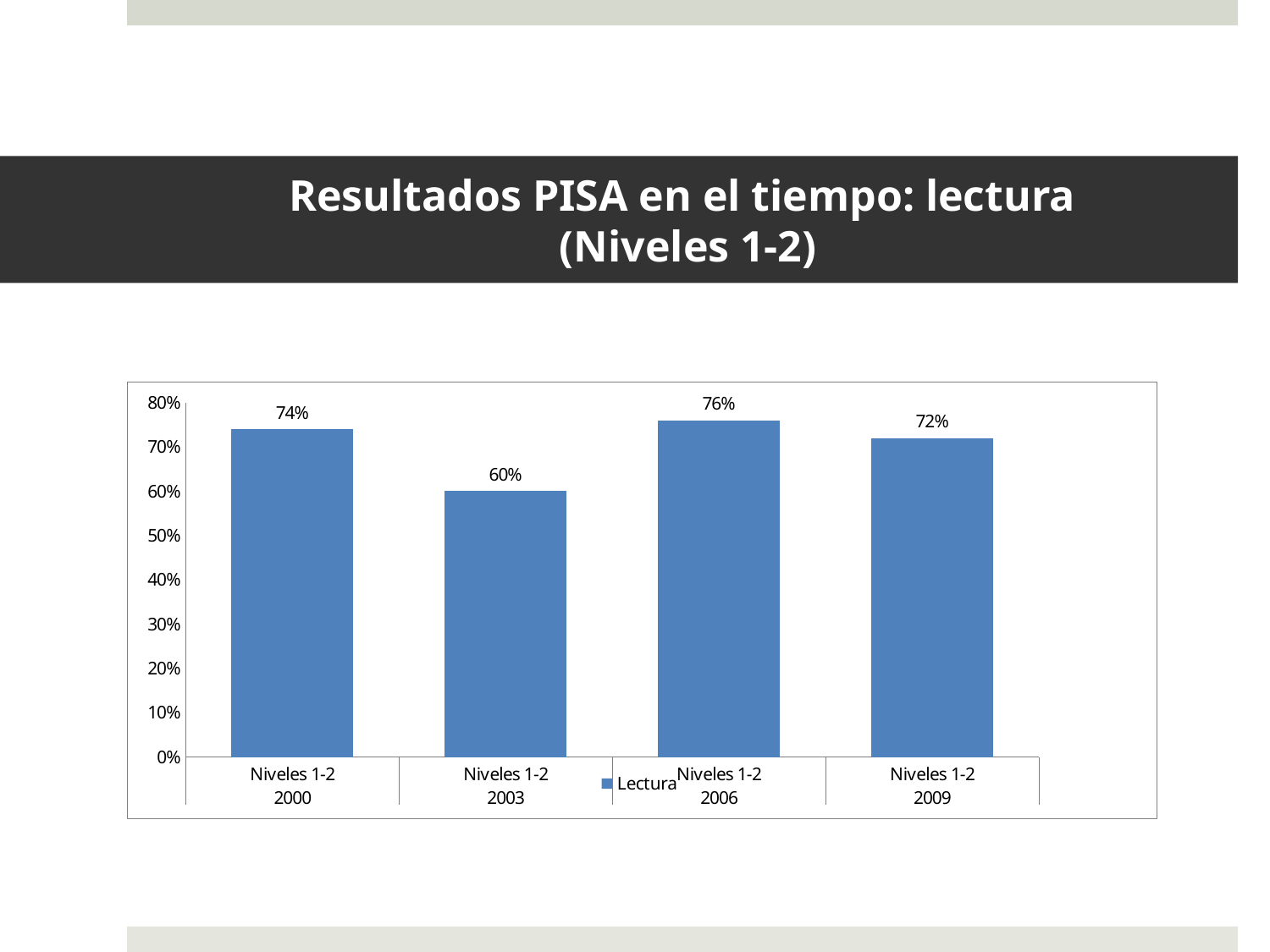
What kind of chart is shown on the slide? Bar chart What is the value for 2006? 76% Which is larger, the value for 2000 or the value for 2009? 2000 What is the value for 2009? 72% What is the name of the series shown in the legend? Lectura How many series does the legend list? 1 What is the value for 2000? 74% What is the difference between the values for 2006 and 2003? 16% How many bars are shown in the chart? 4 What is the value for 2003? 60% Which year has the highest value? 2006 Which year has the lowest value? 2003